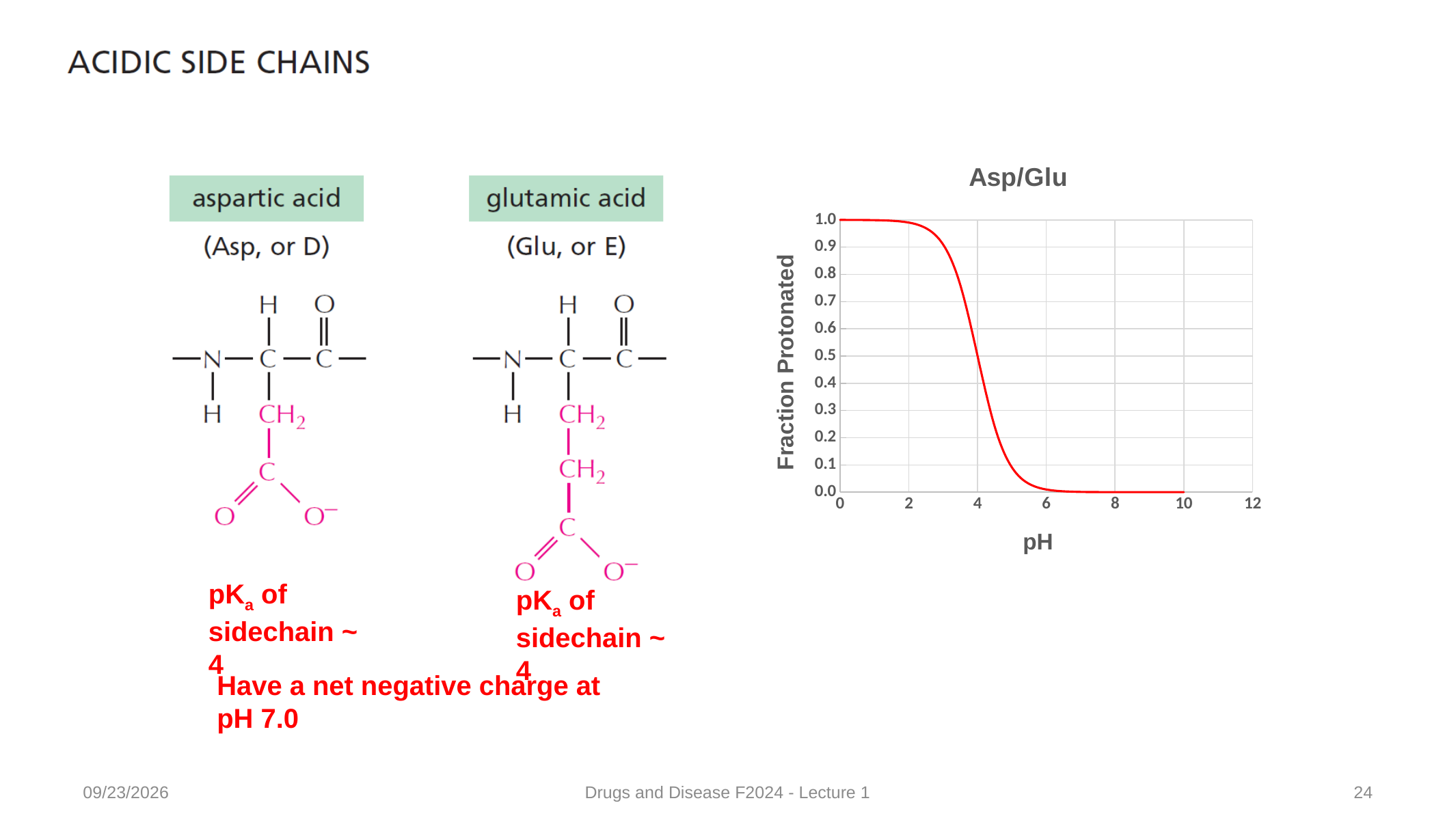
What is the highest pH value labelled on the x axis? 12 Is the fraction protonated at pH 4 greater or less than 0.8? less Which has a higher fraction protonated, pH 2 or pH 6? pH 2 Is the fraction protonated at pH 2 greater or less than 0.9? greater Is the fraction protonated at pH 3 greater or less than 0.5? greater What is the title of the chart? Asp/Glu What is the label of the y axis of the chart? Fraction Protonated What kind of chart is shown on the slide? line chart Does the fraction protonated rise or fall as pH increases along the x axis? fall